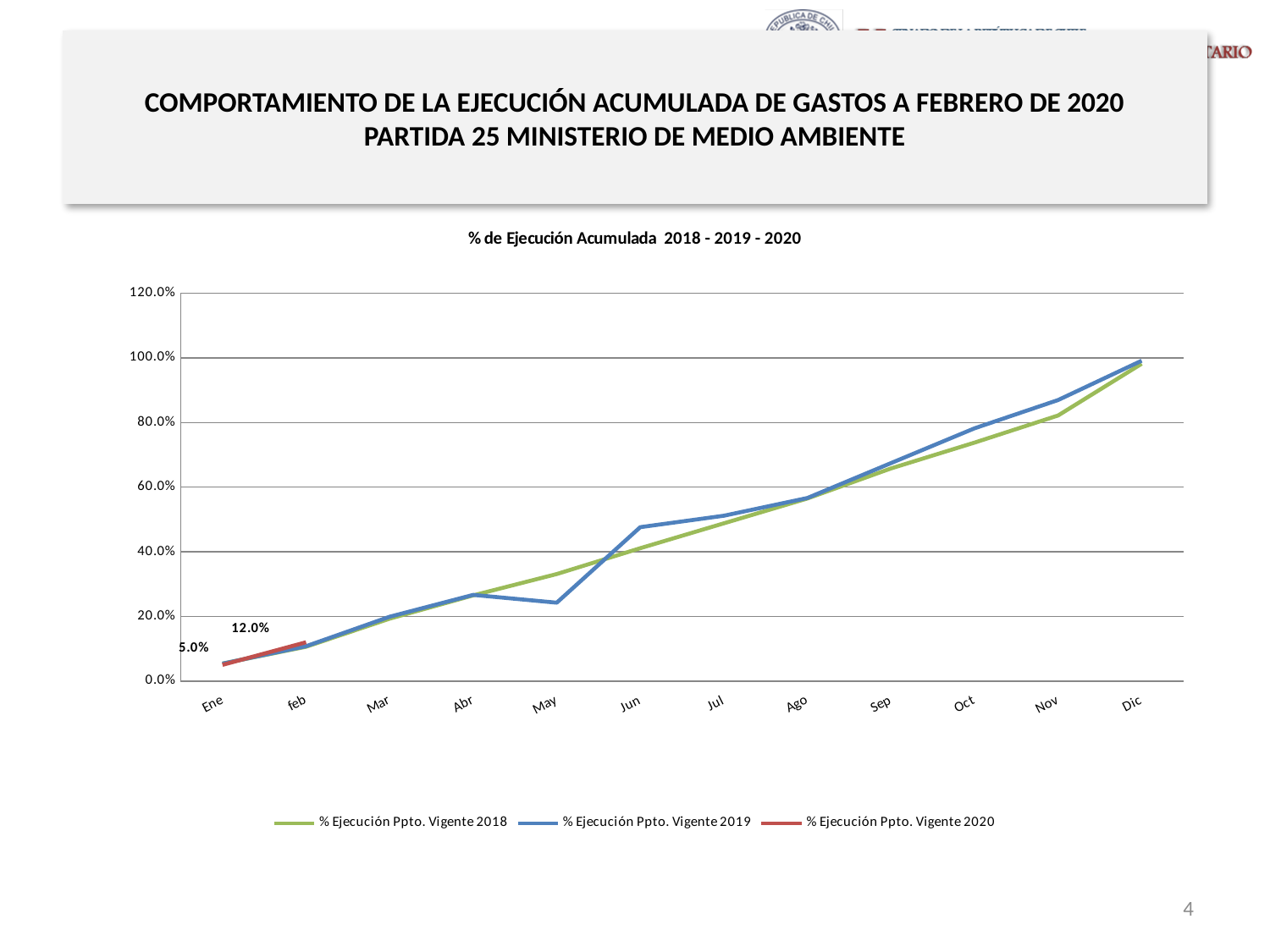
How many series does the legend list? 3 Is the value for % Ejecución Ppto. Vigente 2019 in Nov greater or less than 80.0%? greater What is the difference between the 2020 values for feb and Ene? 7.0% What is the value of % Ejecución Ppto. Vigente 2020 for feb? 12.0% Is the value for % Ejecución Ppto. Vigente 2018 in May greater or less than 40.0%? less Is the value for % Ejecución Ppto. Vigente 2019 in Jun greater or less than 40.0%? greater What kind of chart is shown on the slide? line chart Does the % Ejecución Ppto. Vigente 2018 series rise or fall from Ene to Dic? rise What is the value of % Ejecución Ppto. Vigente 2020 for Ene? 5.0% In Jun, which series has the higher value, % Ejecución Ppto. Vigente 2018 or % Ejecución Ppto. Vigente 2019? % Ejecución Ppto. Vigente 2019 How many months are shown on the x axis? 12 What is the title of the chart? % de Ejecución Acumulada 2018 - 2019 - 2020